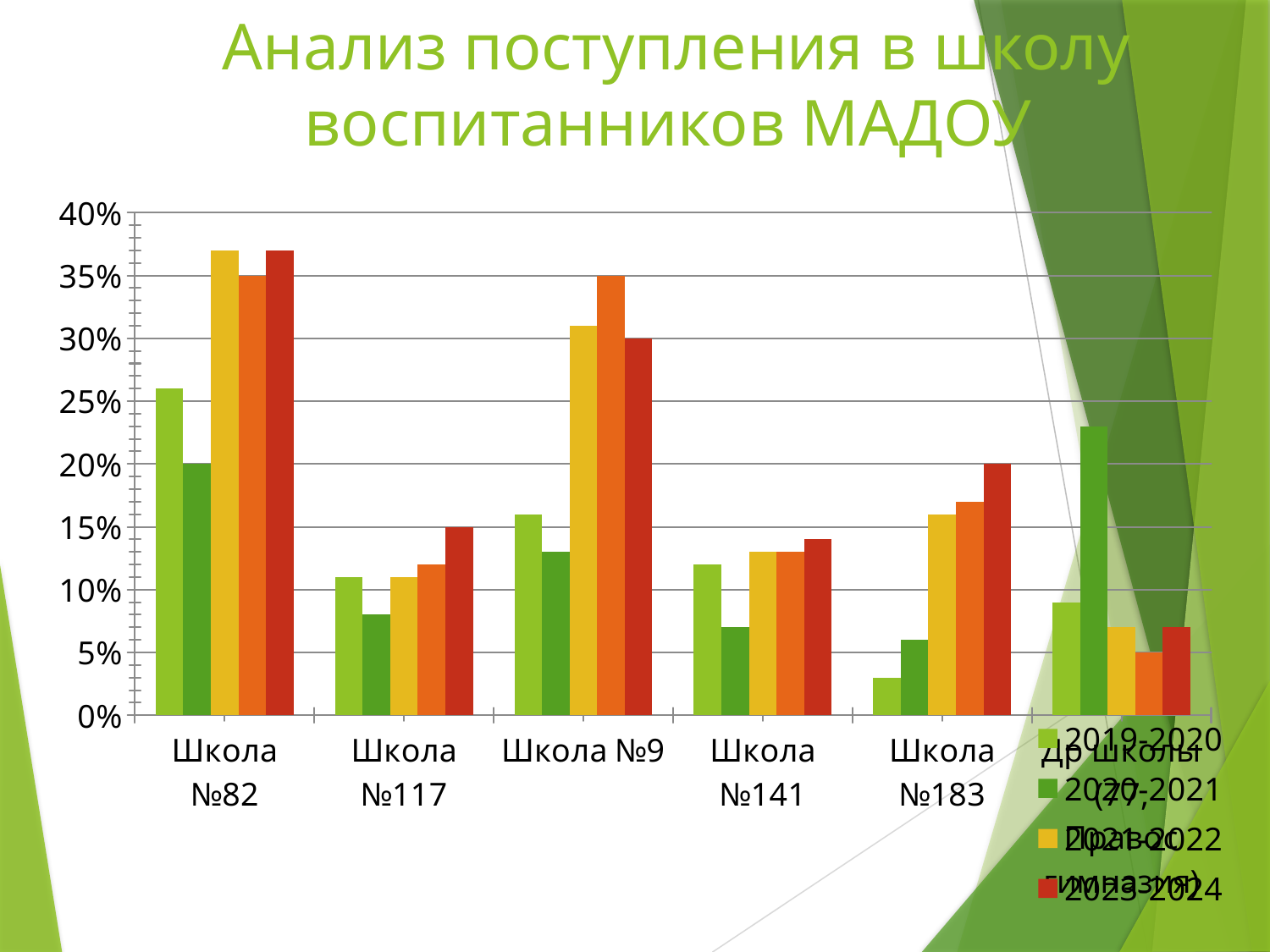
How many school categories are shown along the x axis? 6 Which school has the highest 2019-2020 value? Школа №82 Do the bars for Школа №183 rise or fall from left to right within the group? rise Which school has the higher 2021-2022 value, Школа №183 or Школа №141? Школа №183 What is the title of the slide? Анализ поступления в школу воспитанников МАДОУ Is the 2021-2022 value for Школа №82 greater or less than 30%? greater Is the 2019-2020 value for Школа №82 greater or less than 20%? greater Is the 2019-2020 value for Школа №183 greater or less than 5%? less Which school has the lowest 2019-2020 value? Школа №183 What kind of chart is shown on the slide? bar chart